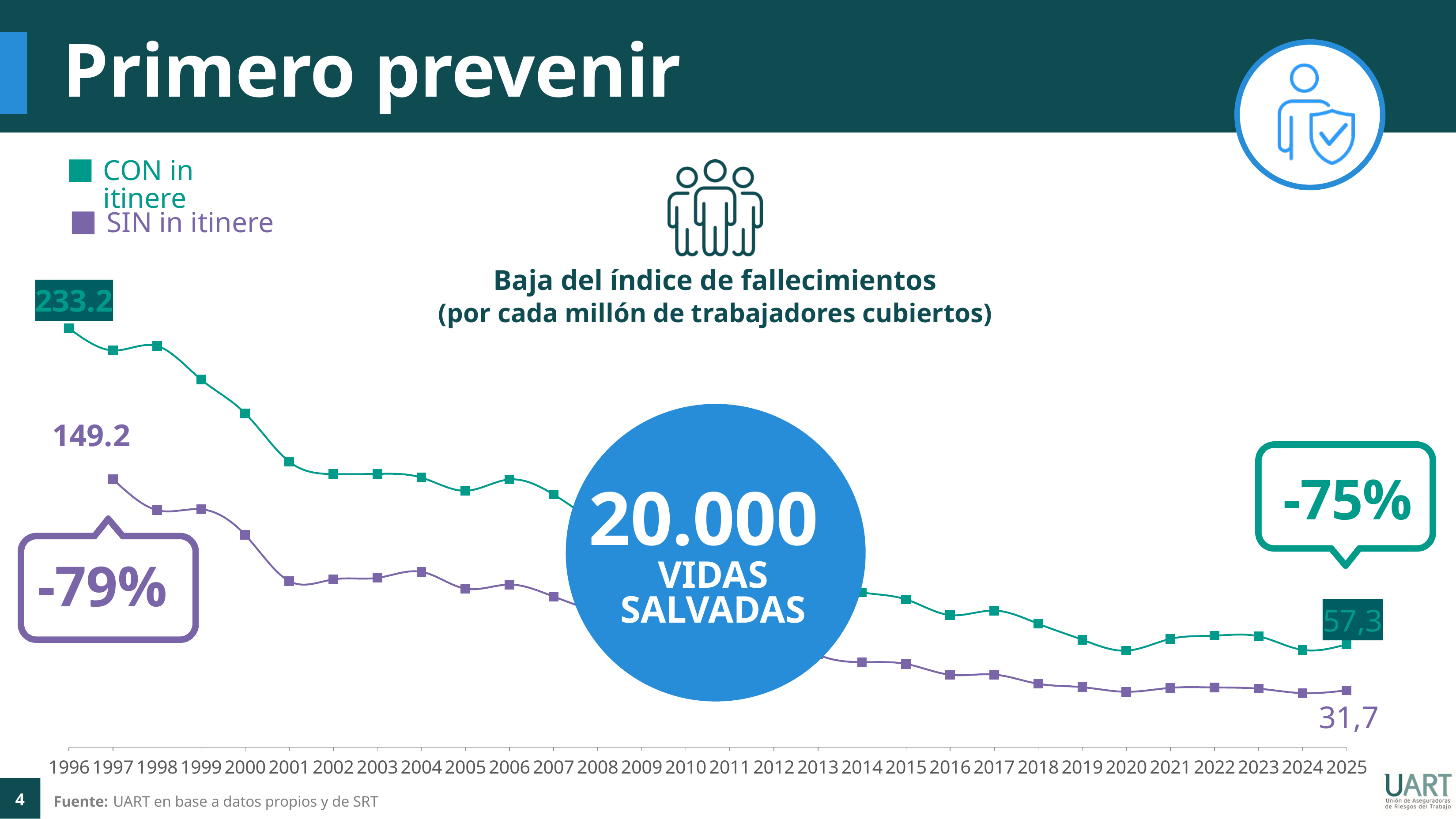
Do the values of the CON in itinere series rise or fall from 1996 to 2025? fall How many series does the legend list? 2 What is the value of the SIN in itinere series in 2025? 31,7 What is the value of the CON in itinere series in 2025? 57,3 What is the first labelled value of the SIN in itinere series? 149.2 What is the value of the CON in itinere series in 1996? 233.2 What are the two series named in the legend? CON in itinere and SIN in itinere What kind of chart is shown on the slide? line chart In which year does the CON in itinere series reach its highest value? 1996 What percentage change is shown in the callout for the SIN in itinere series? -79% How many years are shown on the x axis? 30 Which series has the higher value in 2025, CON in itinere or SIN in itinere? CON in itinere